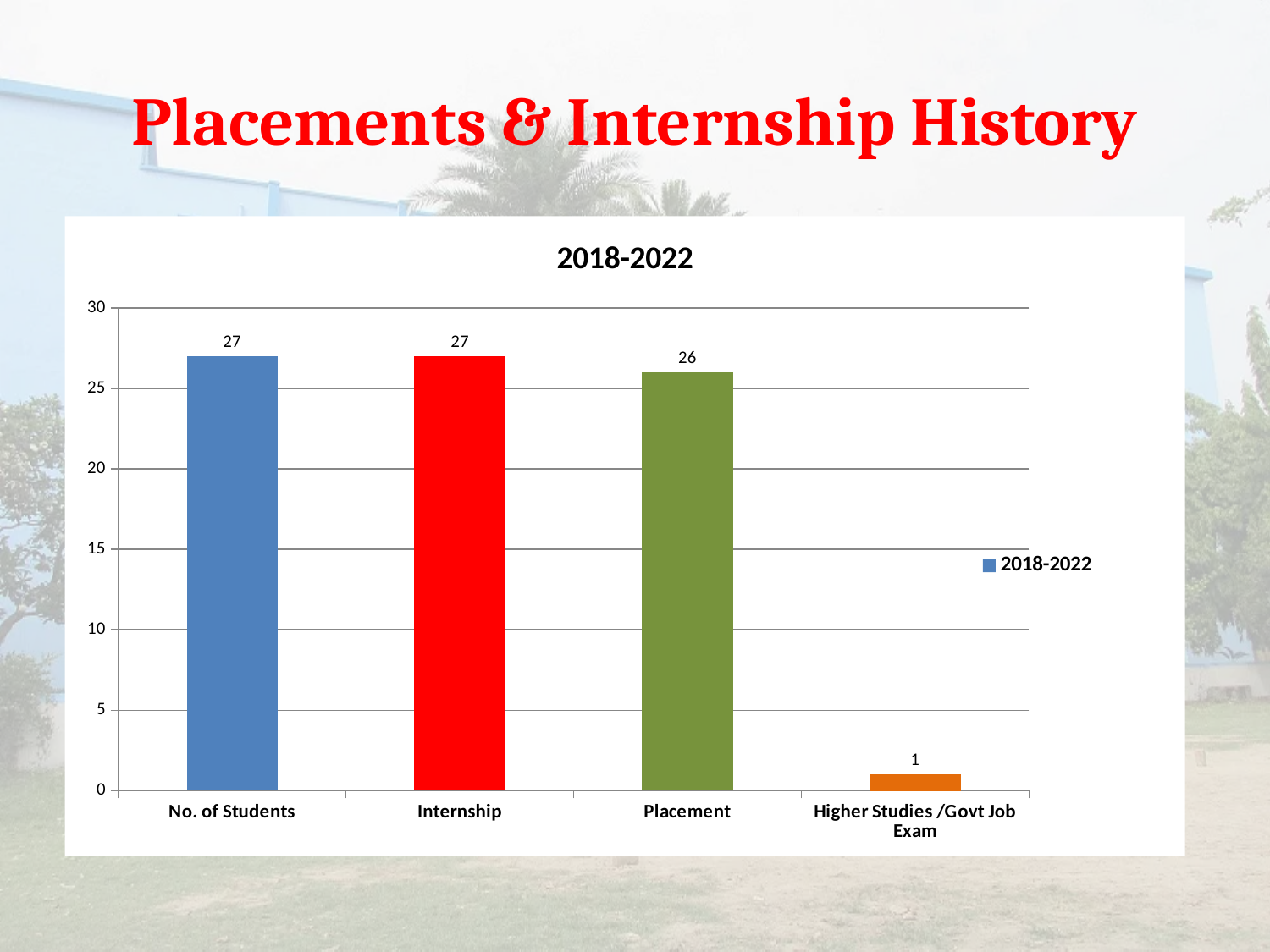
What is the difference between the values for No. of Students and Placement? 1 Which is larger, the value for Internship or the value for Placement? Internship Is the value for Placement greater or less than 20? greater What is the value for Placement? 26 What kind of chart is shown on the slide? bar chart What is the value for Internship? 27 Which category has the lowest value? Higher Studies /Govt Job Exam What is the value for Higher Studies /Govt Job Exam? 1 How many series does the legend list? 1 How many categories are shown on the x axis? 4 What is the title of the chart? 2018-2022 What is the difference between the values for Placement and Higher Studies /Govt Job Exam? 25